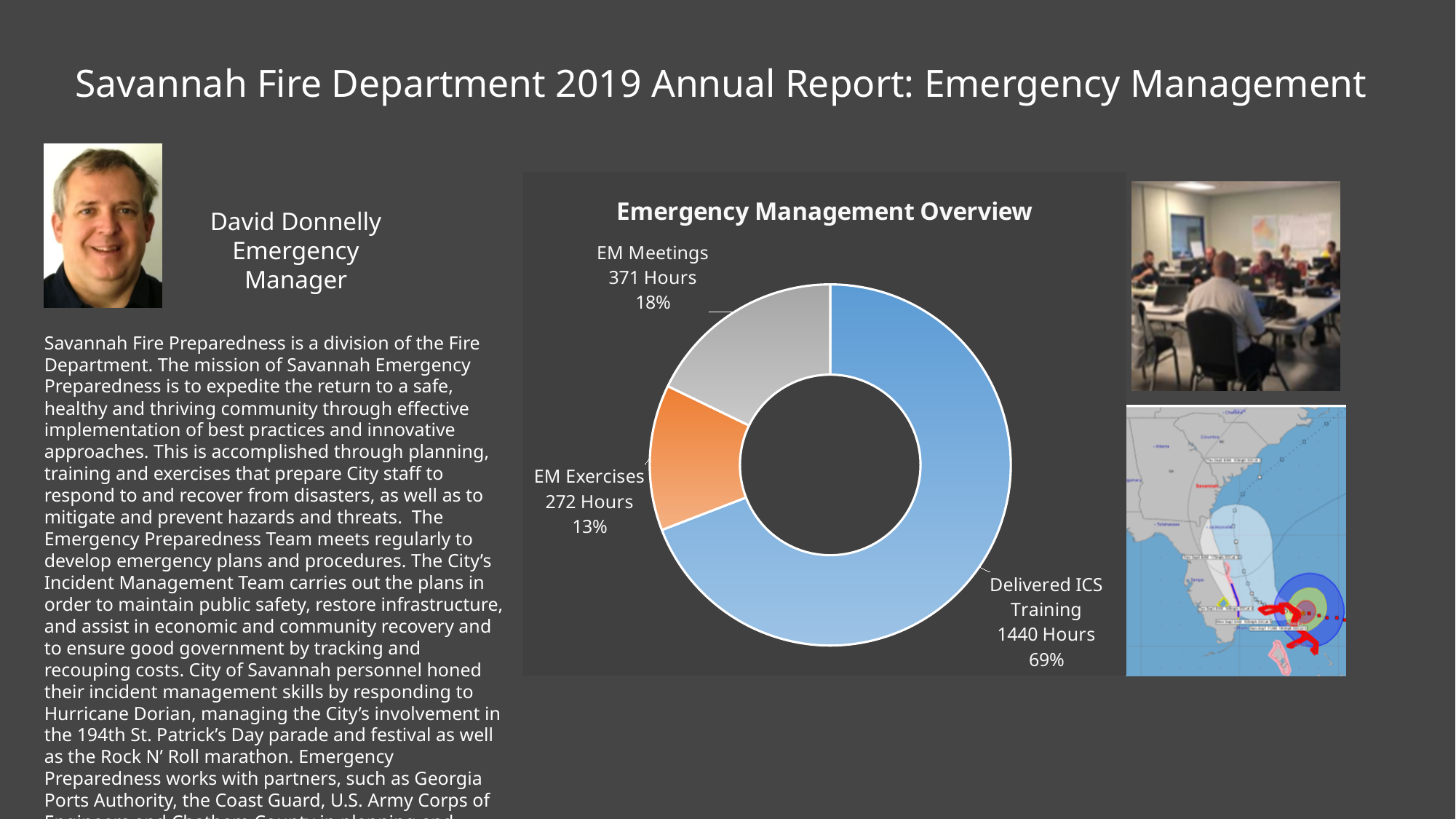
What kind of chart is shown on the slide? Doughnut chart How many hours are shown for EM Exercises? 272 Hours What is the title of the chart? Emergency Management Overview What share of the chart does EM Exercises represent? 13% How many categories does the chart show? 3 Which category has the largest number of hours? Delivered ICS Training Which has more hours, EM Meetings or EM Exercises? EM Meetings How many hours are shown for EM Meetings? 371 Hours What share of the chart does Delivered ICS Training represent? 69% What is the difference in hours between EM Meetings and EM Exercises? 99 Hours Which category has the smallest number of hours? EM Exercises How many hours are shown for Delivered ICS Training? 1440 Hours